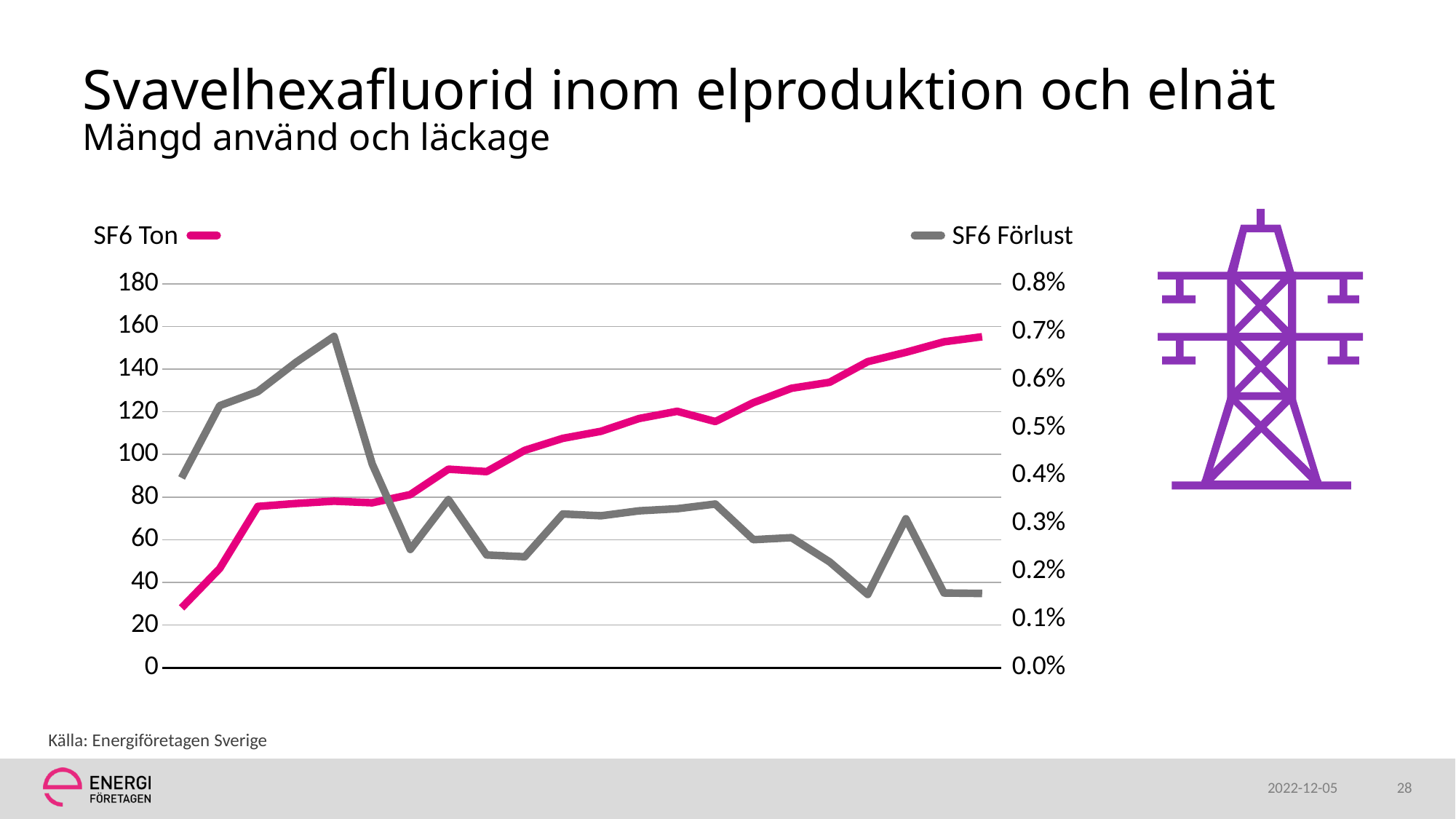
What kind of chart is shown on the slide? line chart Does the SF6 Förlust series generally rise or fall from left to right? fall Is the highest value of the SF6 Förlust series greater or less than 0.6%? greater Is the last (rightmost) value of the SF6 Förlust series greater or less than 0.2%? less Does the SF6 Ton series generally rise or fall from left to right? rise Which series is drawn in pink on the chart? SF6 Ton Is the first (leftmost) value of the SF6 Ton series greater or less than 40? less How many series does the chart's legend list? 2 Which series is drawn in grey on the chart? SF6 Förlust